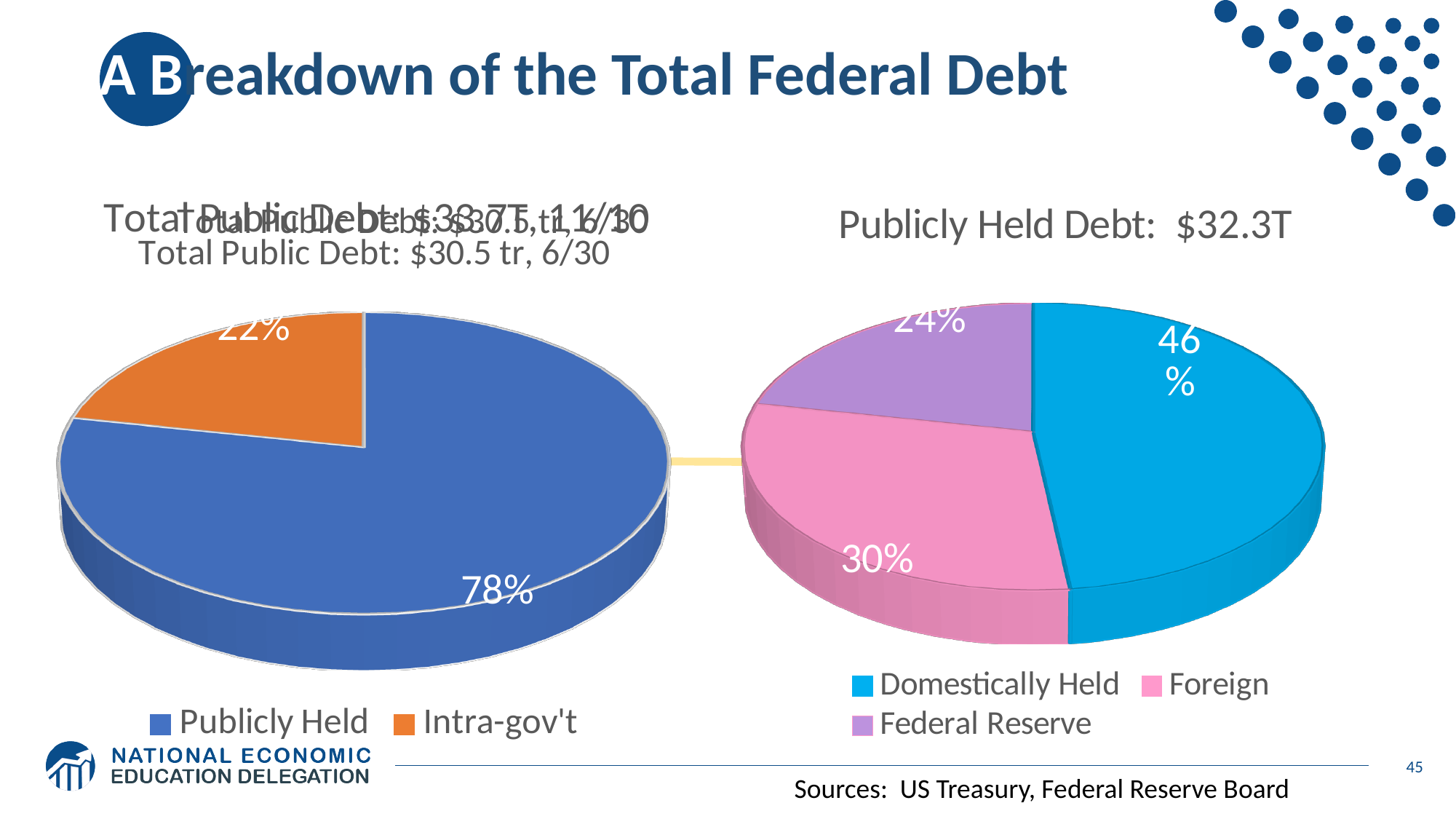
In the 'Publicly Held Debt: $32.3T' chart, what share is Foreign? 30% In the 'Publicly Held Debt: $32.3T' chart, which slice is the smallest? Federal Reserve In the chart on the left of the slide, what share of the total public debt is Intra-gov't? 22% In the chart on the left of the slide, what share of the total public debt is Publicly Held? 78% How many slices does the chart on the left of the slide have? 2 In the chart on the left of the slide, what is the difference in percentage points between the Publicly Held and Intra-gov't slices? 56 How many entries does the legend of the 'Publicly Held Debt: $32.3T' chart list? 3 In the 'Publicly Held Debt: $32.3T' chart, which is larger, the Foreign slice or the Federal Reserve slice? Foreign In the 'Publicly Held Debt: $32.3T' chart, what colour is the Federal Reserve slice? purple What kind of chart is the chart on the left of the slide? pie chart In the chart on the left of the slide, which slice is the largest? Publicly Held